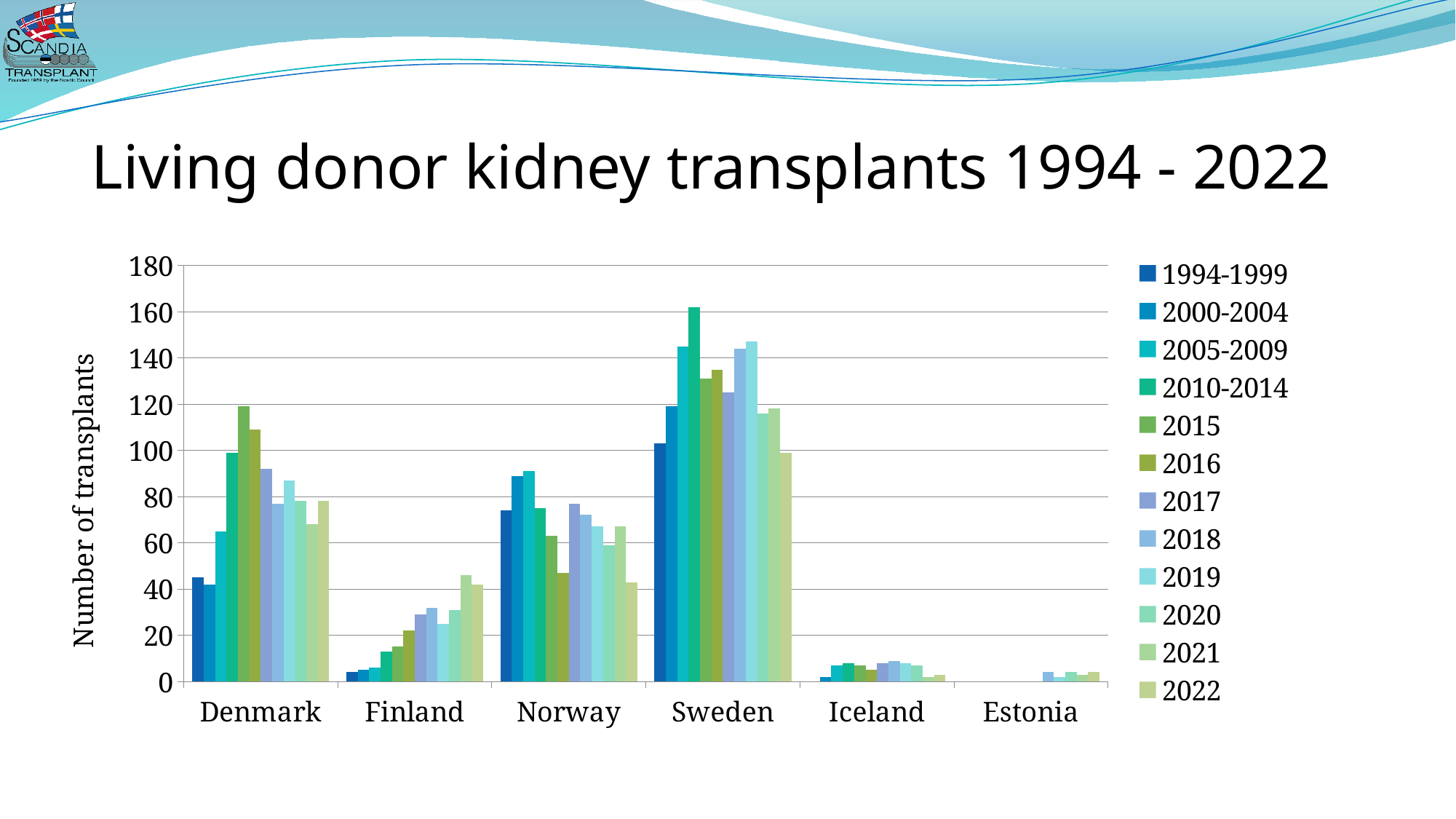
Is the value for Finland in 1994-1999 greater or less than 20? less How many series does the legend list? 12 Which country has the highest number of living donor kidney transplants in any period? Sweden Which is larger, the value for Denmark in 2010-2014 or the value for Norway in 2010-2014? Denmark in 2010-2014 Is the value for Norway in 2022 greater or less than 60? less Is the value for Sweden in 2010-2014 greater or less than 140? greater How many countries are shown on the x axis? 6 Which country has the lowest numbers of living donor kidney transplants across the periods? Estonia What kind of chart is shown on the slide? Bar chart Do the values for Finland generally rise or fall from 1994-1999 to 2022? rise What is the label on the vertical axis? Number of transplants